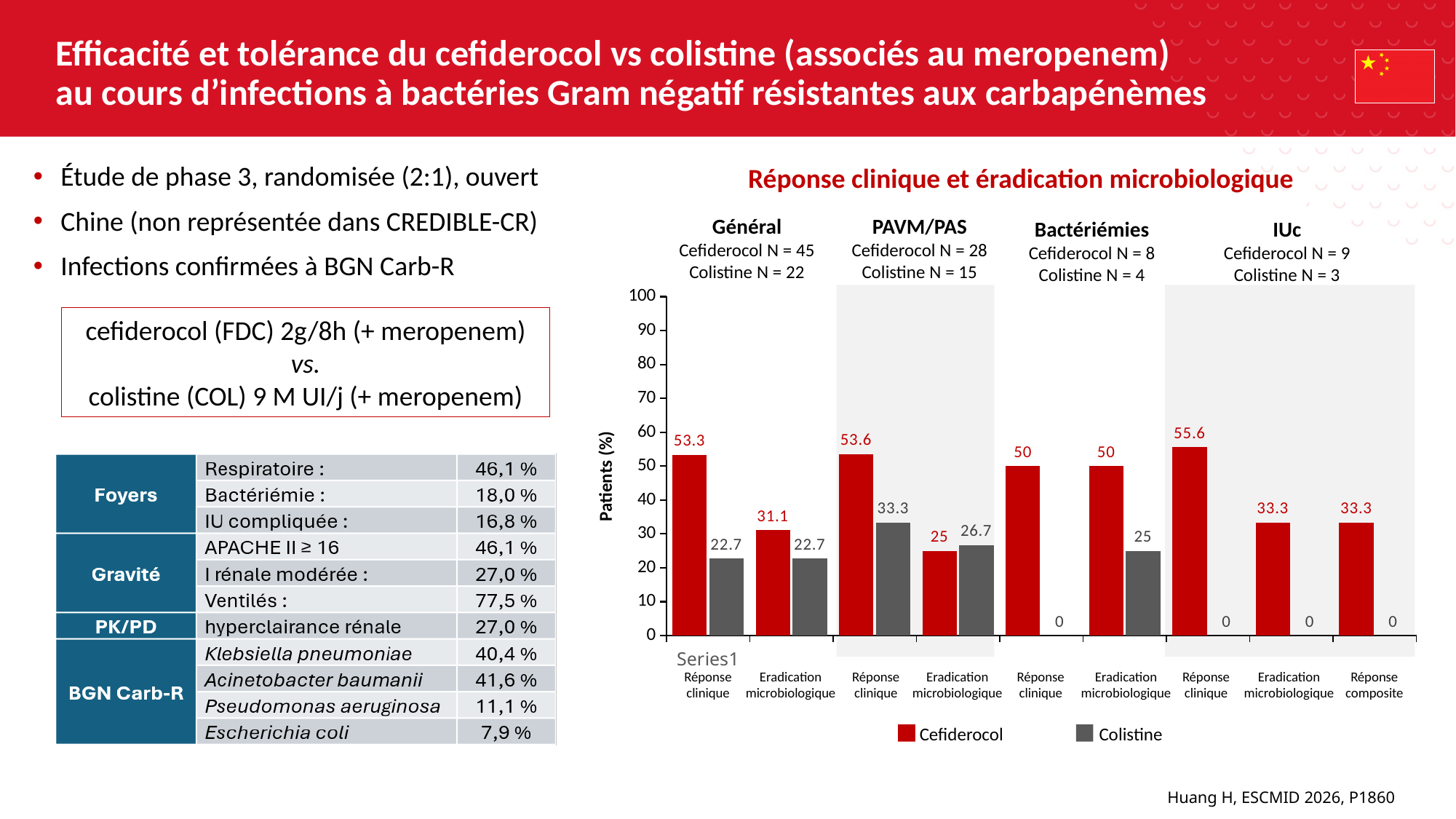
Which group has the highest Cefiderocol value for Réponse clinique? IUc What is the Cefiderocol value for Réponse clinique in the Général group? 53.3 How many series does the chart legend list? 2 What is the Colistine value for Eradication microbiologique in the PAVM/PAS group? 26.7 What type of chart is shown on the slide? bar chart What is the Cefiderocol value for Eradication microbiologique in the Général group? 31.1 What is the difference between the Cefiderocol and Colistine values for Réponse clinique in the Général group? 30.6 What is the Cefiderocol value for Réponse clinique in the IUc group? 55.6 How many category groups (pairs of bars) are plotted along the x axis? 9 What is the Colistine value for Réponse clinique in the Bactériémies group? 0 Which is larger for Eradication microbiologique in the PAVM/PAS group, the Cefiderocol value or the Colistine value? Colistine What colour represents Cefiderocol in the chart legend? red